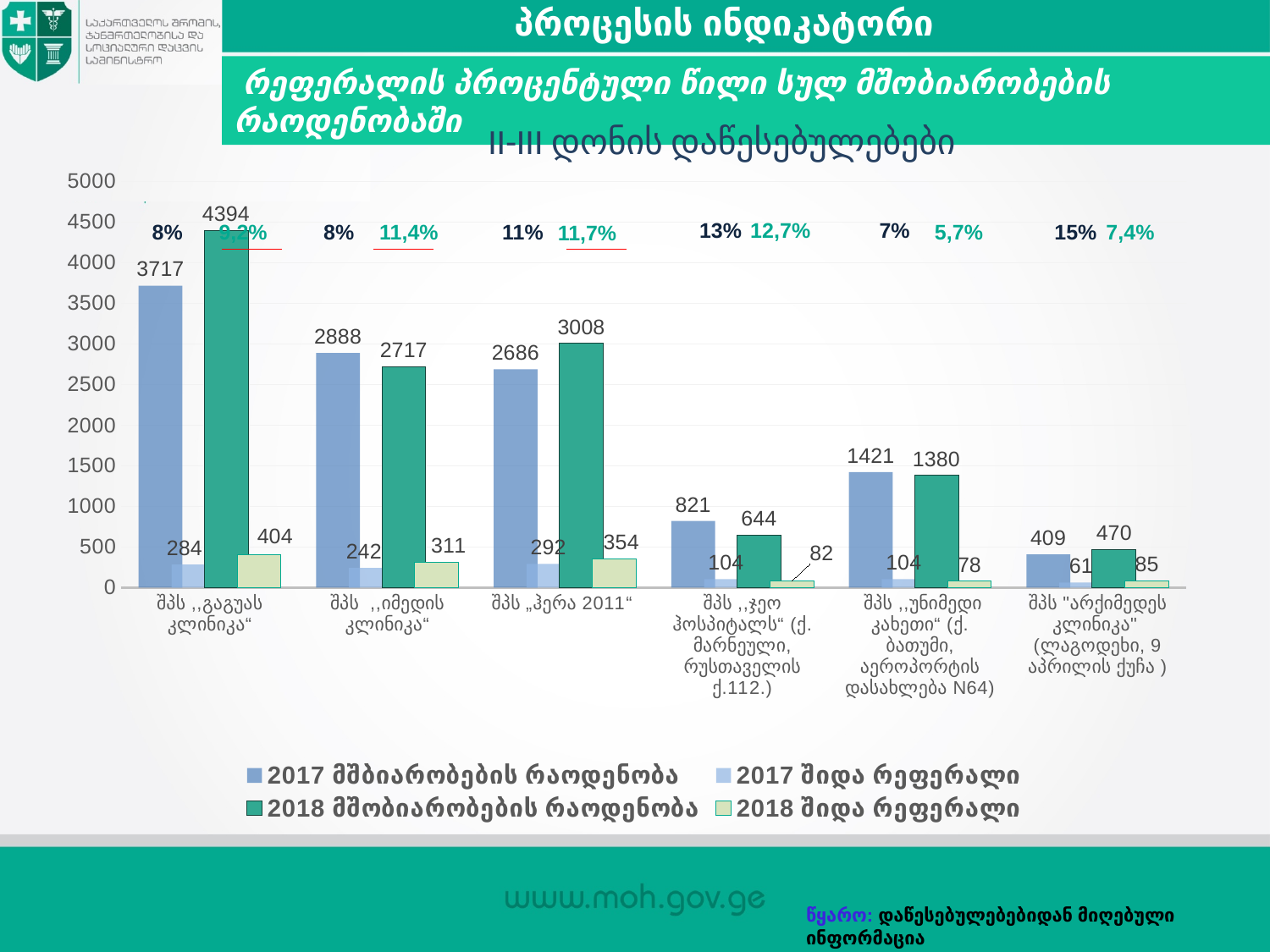
What is the 2018 number of births (2018 მშობიარობების რაოდენობა) for შპს „გაგუას კლინიკა“? 4394 How many series does the legend list? 4 What kind of chart is shown on the slide? Bar chart What is the 2017 number of births (2017 მშბიარობების რაოდენობა) for შპს „პერა 2011“? 2686 Which facility has the highest 2018 number of births? შპს „გაგუას კლინიკა“ For შპს „უნიმედი კახეთი“, which is larger: the 2017 number of births or the 2018 number of births? 2017 number of births (1421) How many facilities (categories) are shown on the x axis? 6 What is the title printed directly above the chart? II-III დონის დაწესებულებები What is the 2018 internal referral value (2018 შიდა რეფერალი) for შპს „იმედის კლინიკა“? 311 What is the 2018 referral percentage shown above the bars for შპს „ჯეო ჰოსპიტალს“? 12,7% What is the difference between the 2018 and 2017 number of births for შპს „პერა 2011“? 322 Which facility has the lowest 2017 number of births? შპს „არქიმედეს კლინიკა“